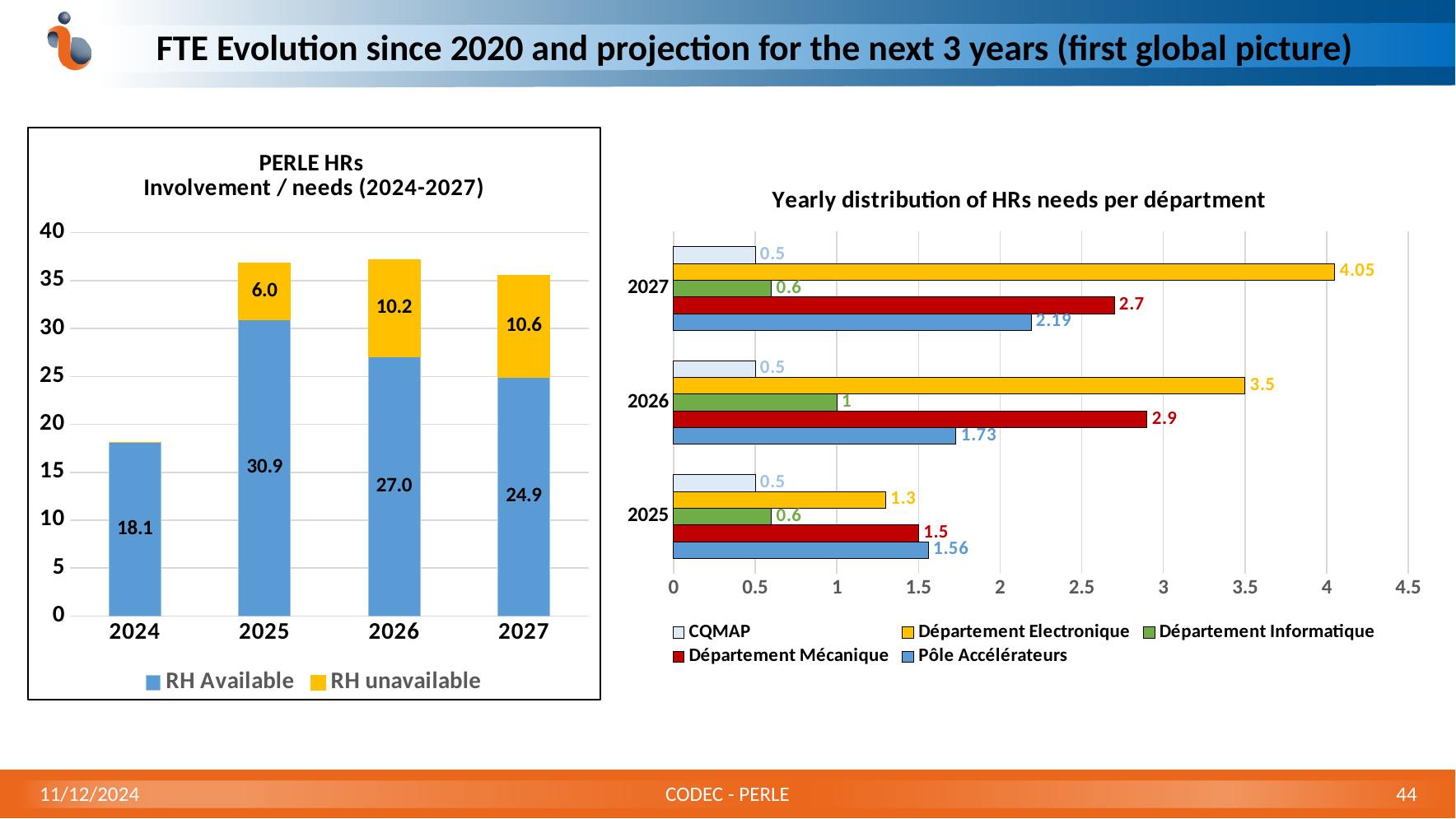
What kind of chart is the 'PERLE HRs Involvement / needs (2024-2027)' chart? Stacked bar chart In the 'Yearly distribution of HRs needs per département' chart, what is the value for Département Electronique in 2027? 4.05 In the 'PERLE HRs Involvement / needs (2024-2027)' chart, what is the difference between the RH Available values for 2024 and 2027? 6.8 In the 'PERLE HRs Involvement / needs (2024-2027)' chart, what is the RH Available value for 2025? 30.9 In the 'PERLE HRs Involvement / needs (2024-2027)' chart, which year has the highest RH Available value? 2025 In the 'Yearly distribution of HRs needs per département' chart, what is the value for Pôle Accélérateurs in 2026? 1.73 In the 'Yearly distribution of HRs needs per département' chart, is the value for Département Mécanique in 2026 larger than the value for Département Mécanique in 2027? Yes In the 'Yearly distribution of HRs needs per département' chart, which département has the highest value in 2025? Pôle Accélérateurs In the 'PERLE HRs Involvement / needs (2024-2027)' chart, what is the total of the stacked bar for 2026? 37.2 In the 'PERLE HRs Involvement / needs (2024-2027)' chart, what is the RH unavailable value for 2027? 10.6 In the 'PERLE HRs Involvement / needs (2024-2027)' chart, how many series does the legend list? 2 In the 'Yearly distribution of HRs needs per département' chart, how many départements does the legend list? 5